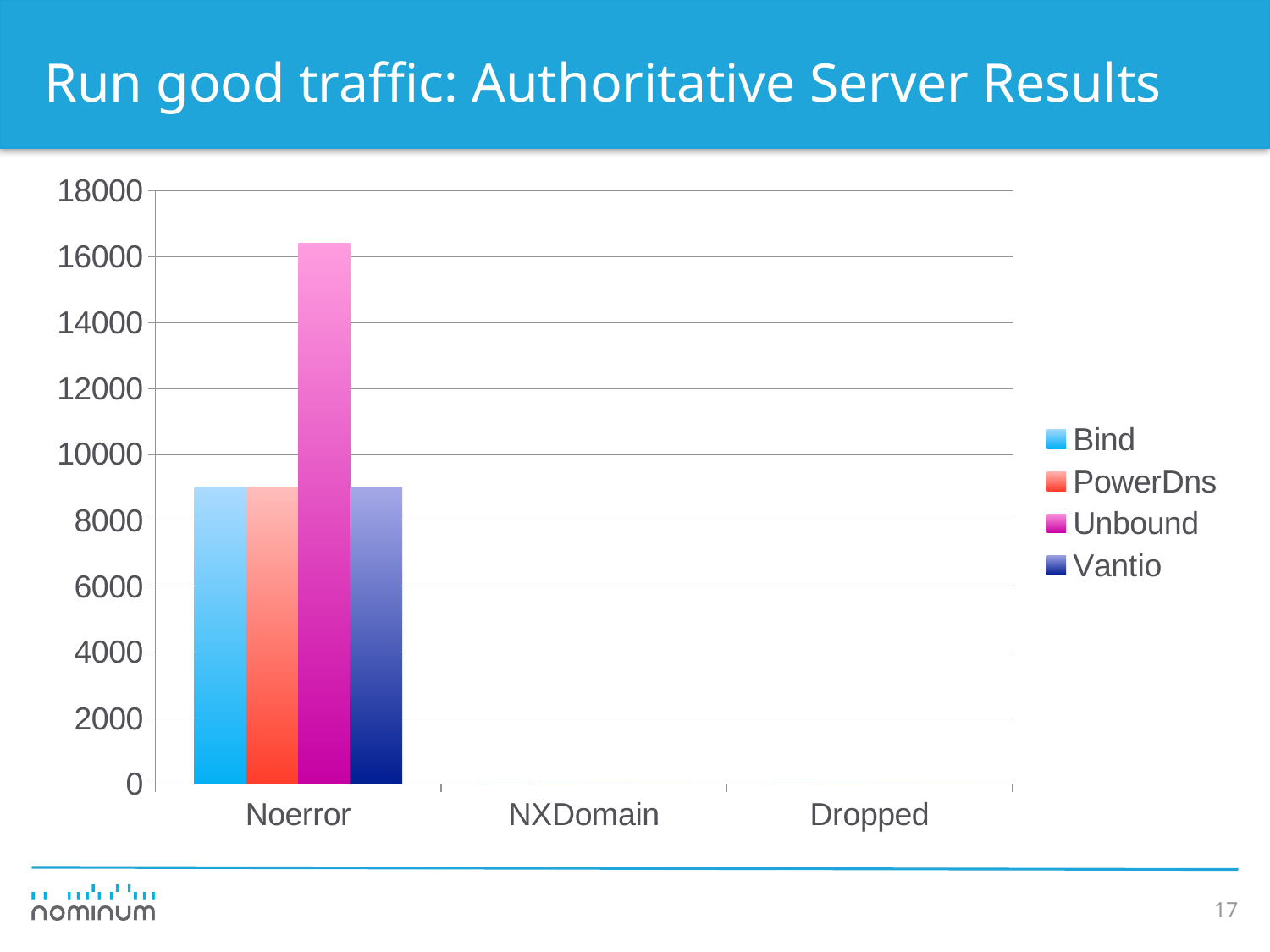
Is the value for Bind in the Noerror category greater or less than 10000? less Is the value for Unbound in the NXDomain category greater or less than 2000? less What is the title of the slide containing the chart? Run good traffic: Authoritative Server Results For Noerror, which is larger: the value for Unbound or the value for PowerDns? Unbound How many categories are shown on the x axis? 3 Which category has the highest values across all series? Noerror Which series is shown in magenta in the legend? Unbound How many series does the legend list? 4 Is the value for Unbound in the Noerror category greater or less than 14000? greater Which series has the highest value for Noerror? Unbound What kind of chart is shown on the slide? bar chart